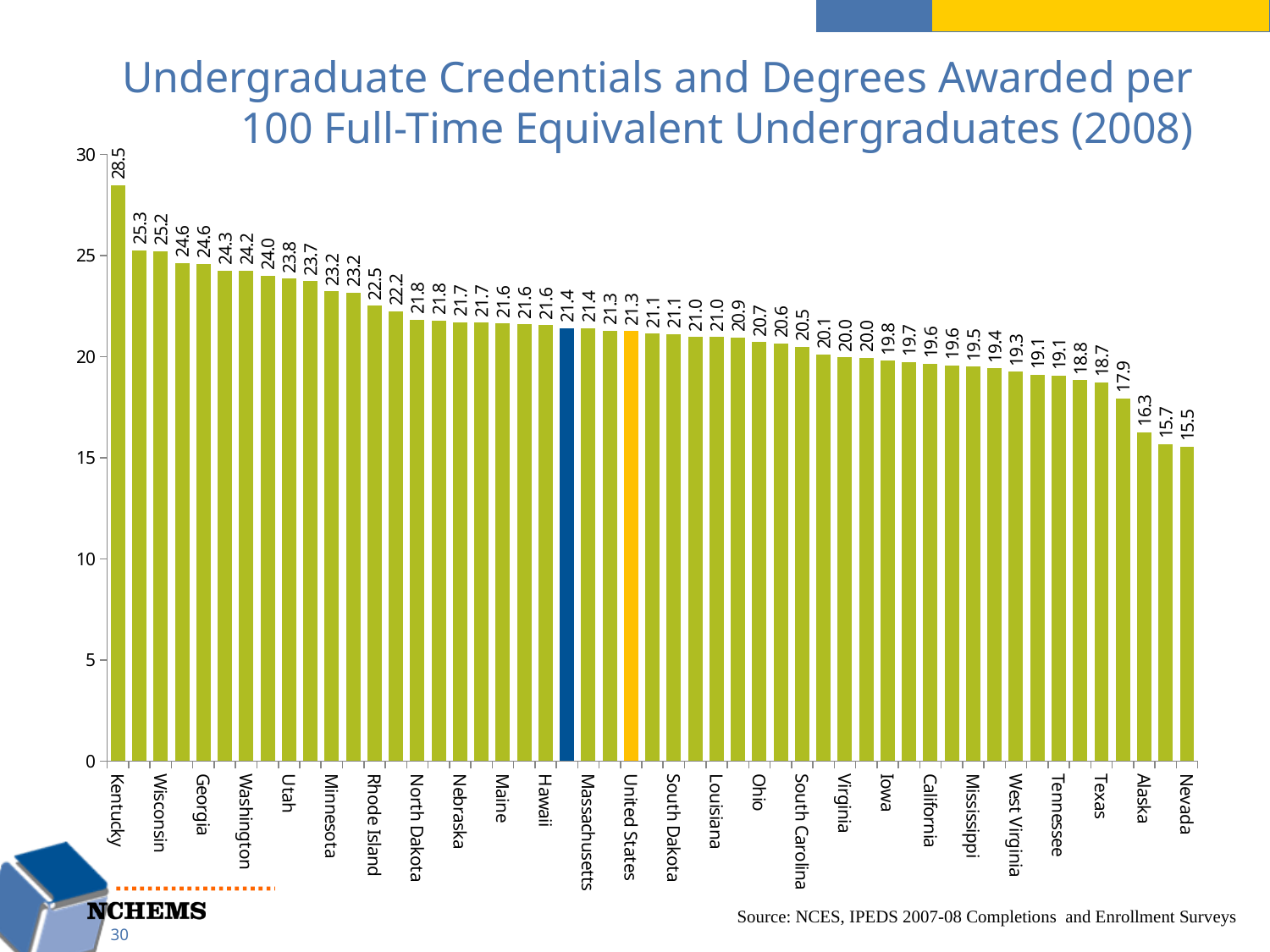
Which state has the highest number of undergraduate credentials and degrees awarded per 100 FTE undergraduates? Kentucky What is the value for Kentucky? 28.5 Do the values rise or fall moving from left to right along the x axis? fall What is the difference between the values for Kentucky and Nevada? 13.0 Which state has the lowest value on the chart? Nevada What is the value for Nevada? 15.5 How many bars are plotted on the chart? 51 Which category is shown with an orange bar? United States What kind of chart is shown on the slide? bar chart What is the value for the United States? 21.3 Which has a larger value, Kentucky or Nevada? Kentucky Is the value for Alaska greater or less than 20? less